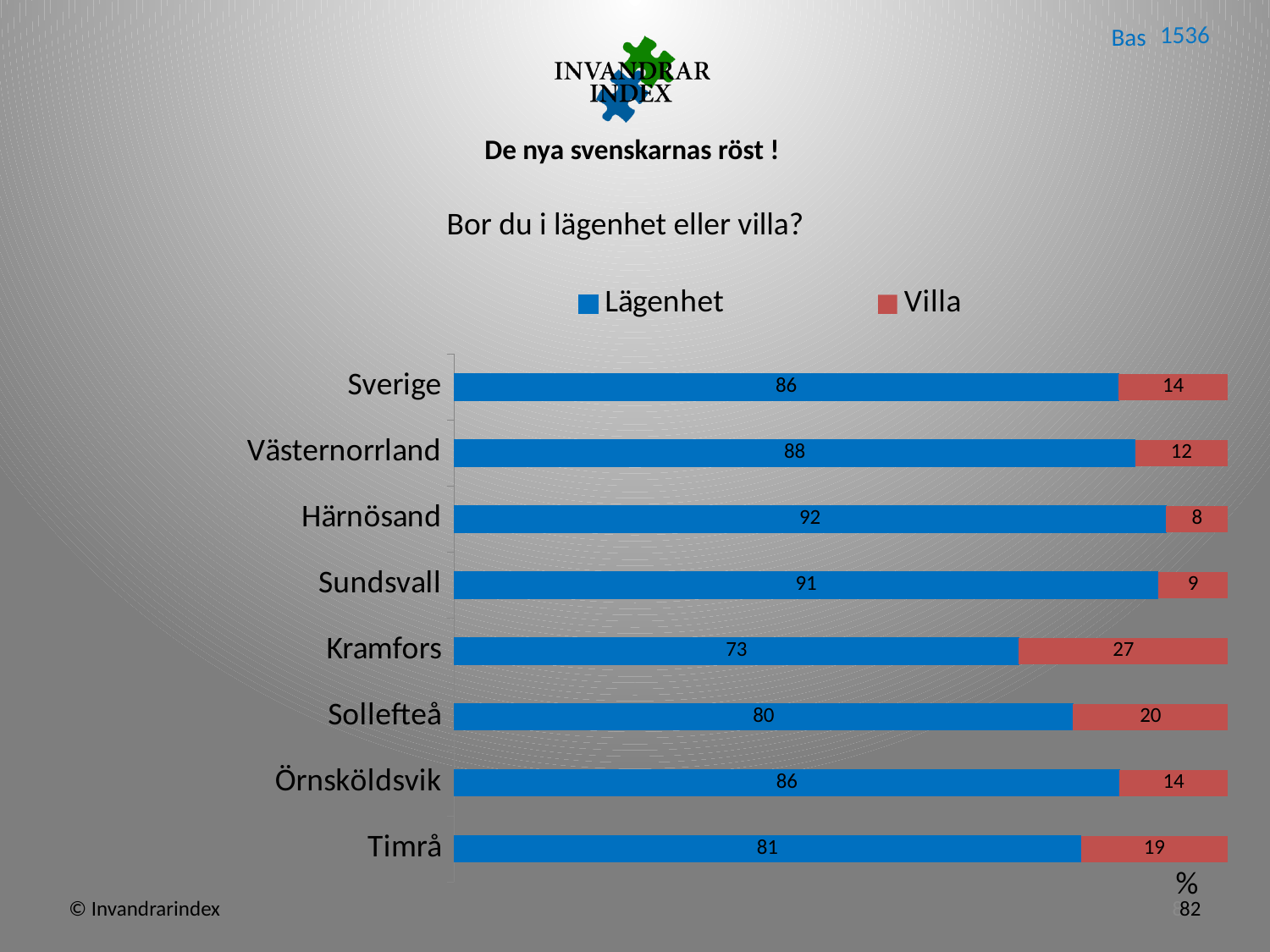
How many categories are shown on the chart? 8 What is the title of the chart? Bor du i lägenhet eller villa? Which category has the highest Villa value? Kramfors What is the total of the stacked bar for Sundsvall? 100 What is the Lägenhet value for Härnösand? 92 Which category has the lowest Lägenhet value? Kramfors Which is larger, the Villa value for Sollefteå or the Villa value for Timrå? Sollefteå How many series does the legend list? 2 What is the difference between the Lägenhet values for Härnösand and Sollefteå? 12 What kind of chart is shown on the slide? Stacked bar chart What is the Villa value for Kramfors? 27 What is the Lägenhet value for Timrå? 81